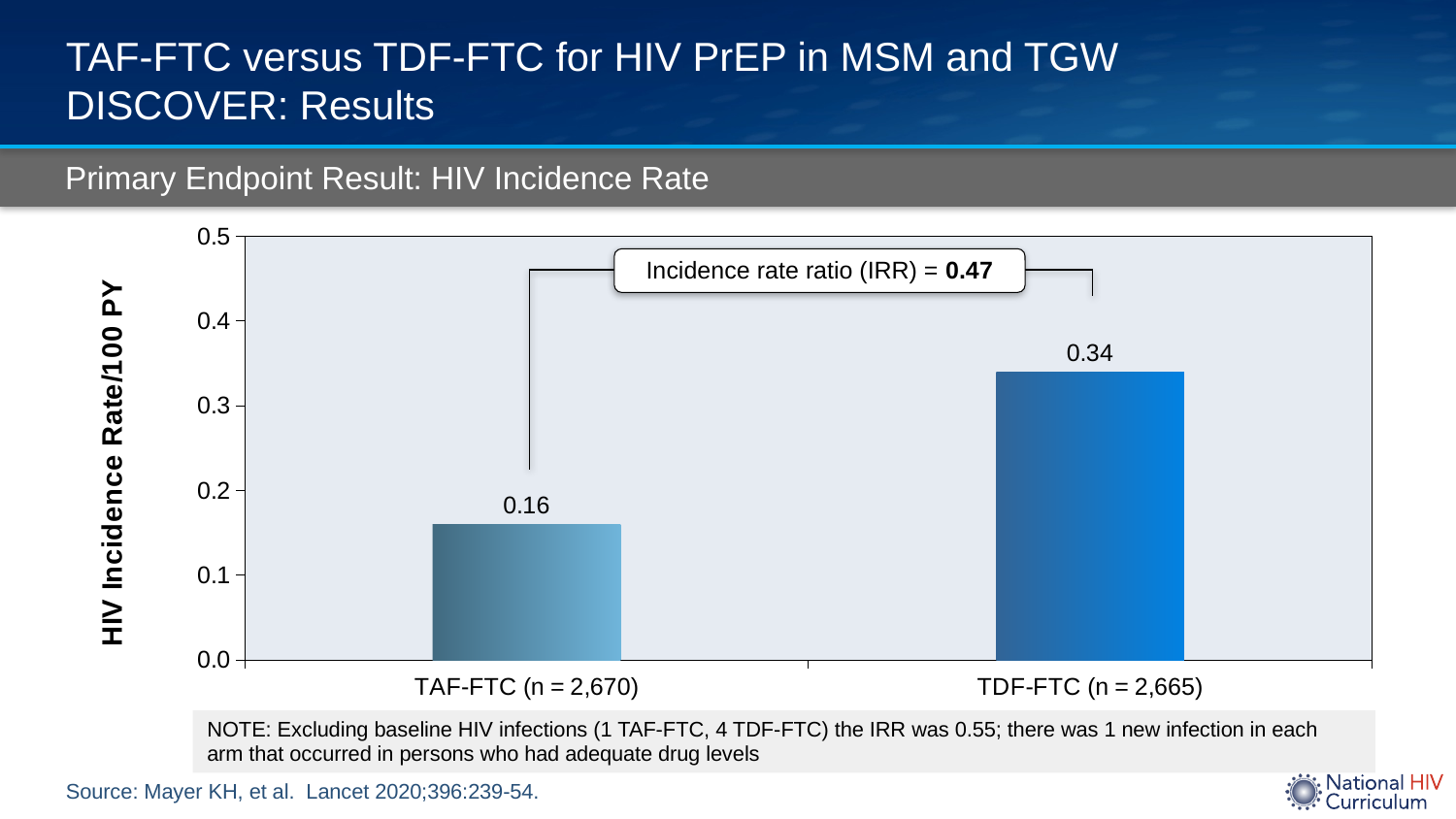
What is the HIV incidence rate per 100 PY for TDF-FTC (n = 2,665)? 0.34 Is the HIV incidence rate higher for TAF-FTC or TDF-FTC? TDF-FTC What type of chart is shown on the slide? Bar chart What is the label of the y-axis? HIV Incidence Rate/100 PY Which arm has the lower HIV incidence rate? TAF-FTC (n = 2,670) Is the HIV incidence rate for TAF-FTC greater or less than 0.2? less How many bars are shown in the chart? 2 What is the HIV incidence rate per 100 PY for TAF-FTC (n = 2,670)? 0.16 Which arm has the higher HIV incidence rate? TDF-FTC (n = 2,665) Is the HIV incidence rate for TDF-FTC greater or less than 0.3? greater What is the incidence rate ratio (IRR) shown on the chart? 0.47 What is the difference in HIV incidence rate between TDF-FTC and TAF-FTC? 0.18